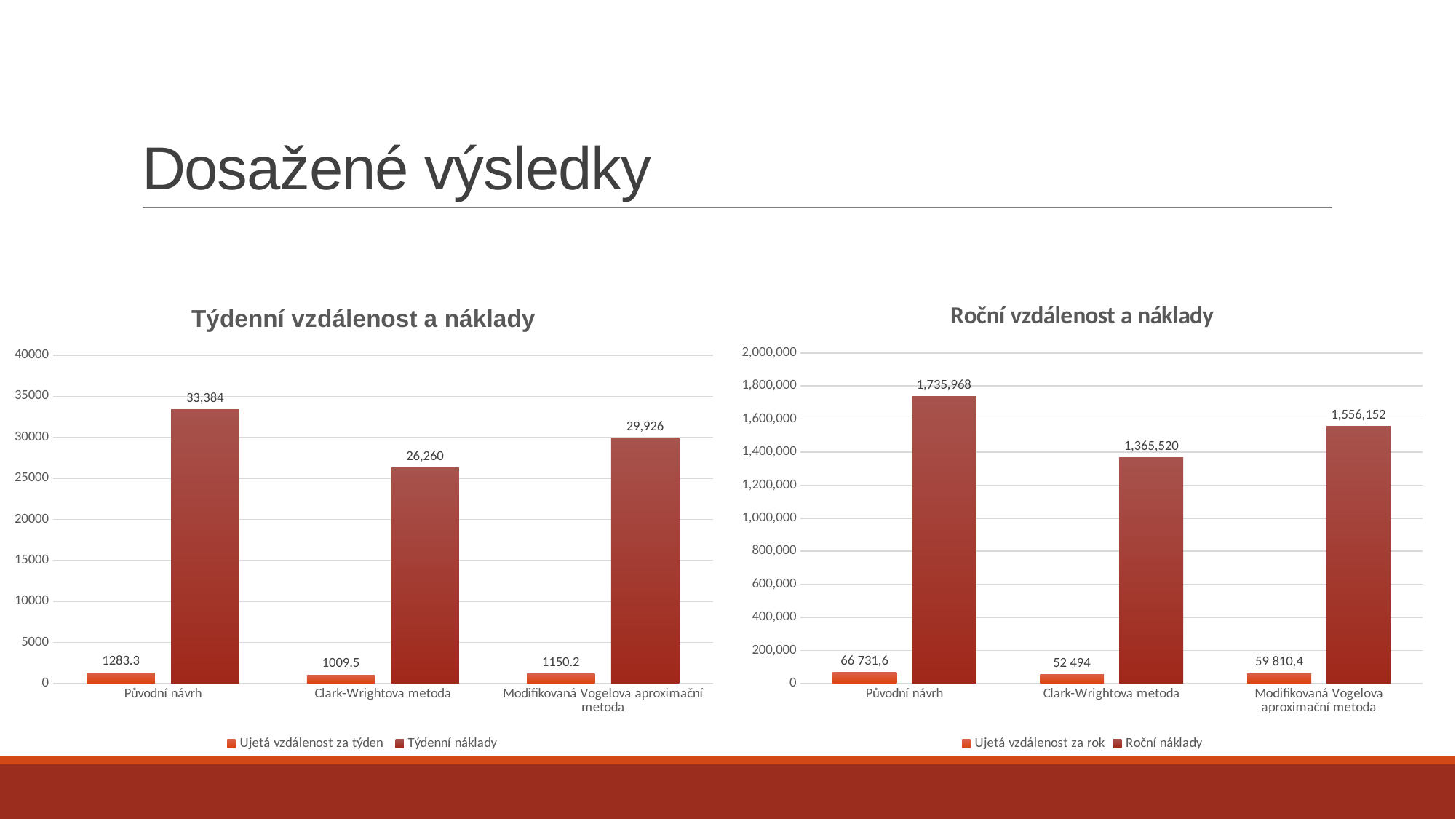
In the chart 'Roční vzdálenost a náklady', is the Roční náklady for Clark-Wrightova metoda greater or less than 1,400,000? less In the chart 'Týdenní vzdálenost a náklady', how many series does the legend list? 2 In the chart 'Roční vzdálenost a náklady', what is the difference in Roční náklady between Původní návrh and Clark-Wrightova metoda? 370,448 In the chart 'Roční vzdálenost a náklady', which category has the highest Roční náklady? Původní návrh What type of chart is 'Týdenní vzdálenost a náklady'? bar chart In the chart 'Týdenní vzdálenost a náklady', what is the difference in Týdenní náklady between Původní návrh and Clark-Wrightova metoda? 7,124 In the chart 'Týdenní vzdálenost a náklady', which category has the lowest Týdenní náklady? Clark-Wrightova metoda In the chart 'Týdenní vzdálenost a náklady', what is the value of Ujetá vzdálenost za týden for Clark-Wrightova metoda? 1009.5 In the chart 'Roční vzdálenost a náklady', how many categories are shown on the x axis? 3 In the chart 'Týdenní vzdálenost a náklady', what is the value of Týdenní náklady for Původní návrh? 33,384 In the chart 'Roční vzdálenost a náklady', what is the value of Ujetá vzdálenost za rok for Původní návrh? 66 731,6 In the chart 'Roční vzdálenost a náklady', what is the value of Roční náklady for Modifikovaná Vogelova aproximační metoda? 1,556,152